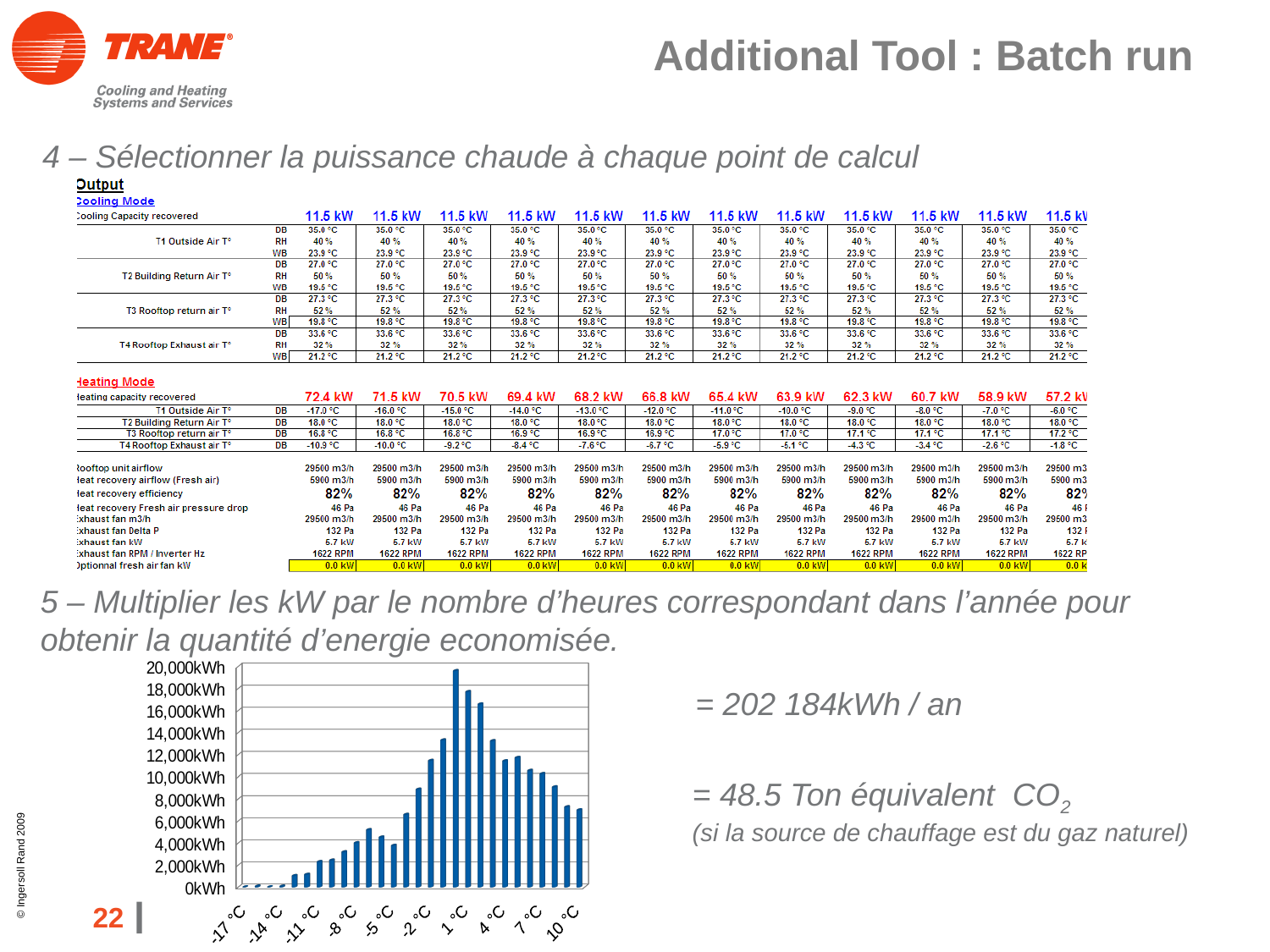
What is the highest value shown on the y axis of the bar chart? 20,000kWh What kind of chart is shown at the bottom of the slide? bar chart Is the value for -17 °C greater or less than 2,000kWh? less Which has the larger value, -8 °C or 4 °C? 4 °C Is the value for 10 °C greater or less than 4,000kWh? greater What unit is used on the y axis of the bar chart? kWh Do the values generally rise or fall along the x axis from -17 °C to -2 °C? rise Is the tallest bar in the chart greater or less than 18,000kWh? greater How many temperature labels are shown on the x axis of the bar chart? 10 Which has the larger value, -17 °C or 10 °C? 10 °C Do the values generally rise or fall along the x axis from 4 °C to 10 °C? fall